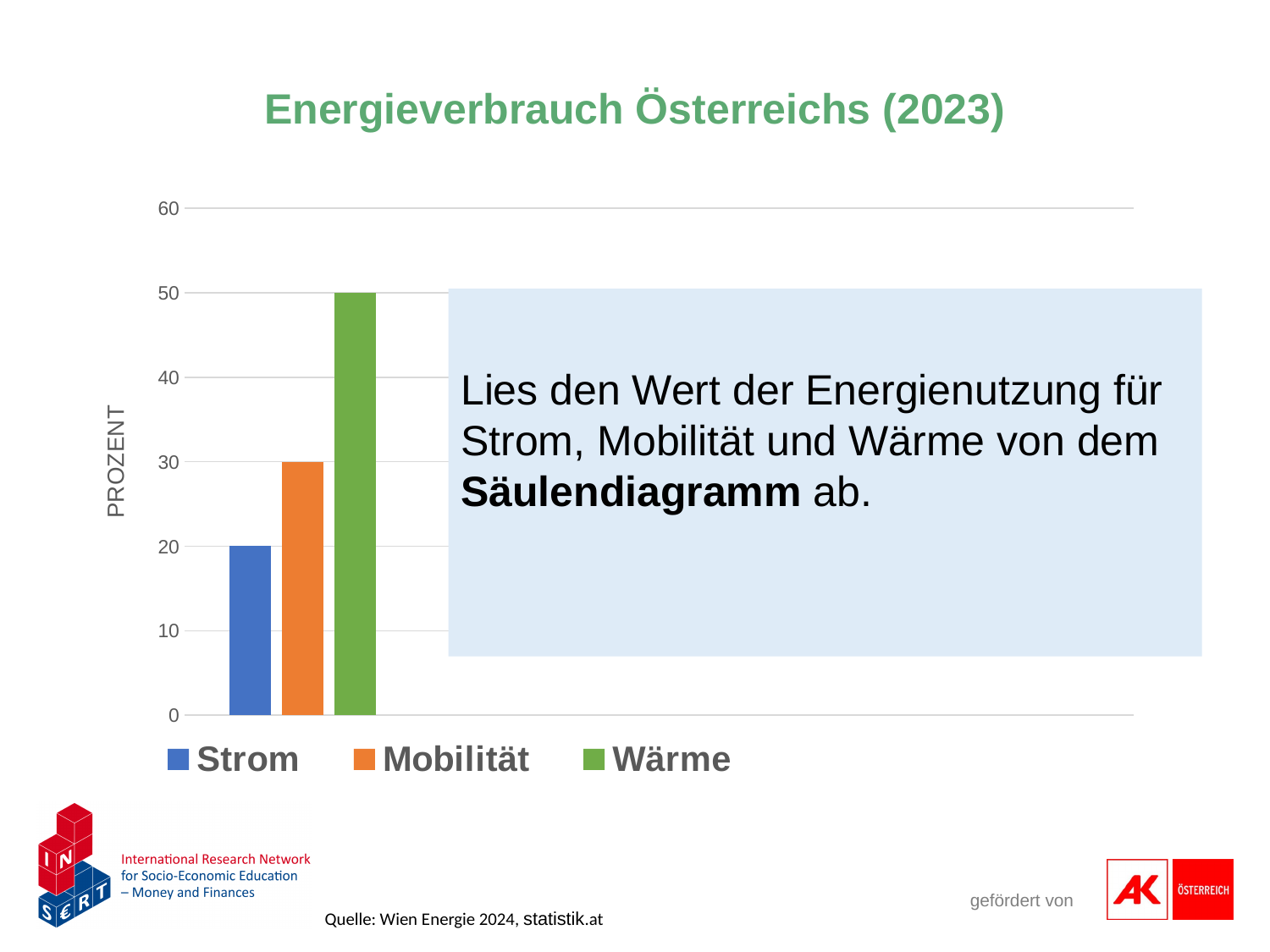
Which is larger, the value for Mobilität or the value for Strom? Mobilität What is the title of the chart? Energieverbrauch Österreichs (2023) Which category has the highest value? Wärme Which category has the lowest value? Strom What kind of chart is shown on the slide? bar chart Is the value for Wärme greater or less than 40? greater What is the difference between the values for Mobilität and Strom? 10 What is the difference between the values for Wärme and Strom? 30 How many series does the legend list? 3 What is the value for Strom? 20 What is the value for Mobilität? 30 What is the value for Wärme? 50